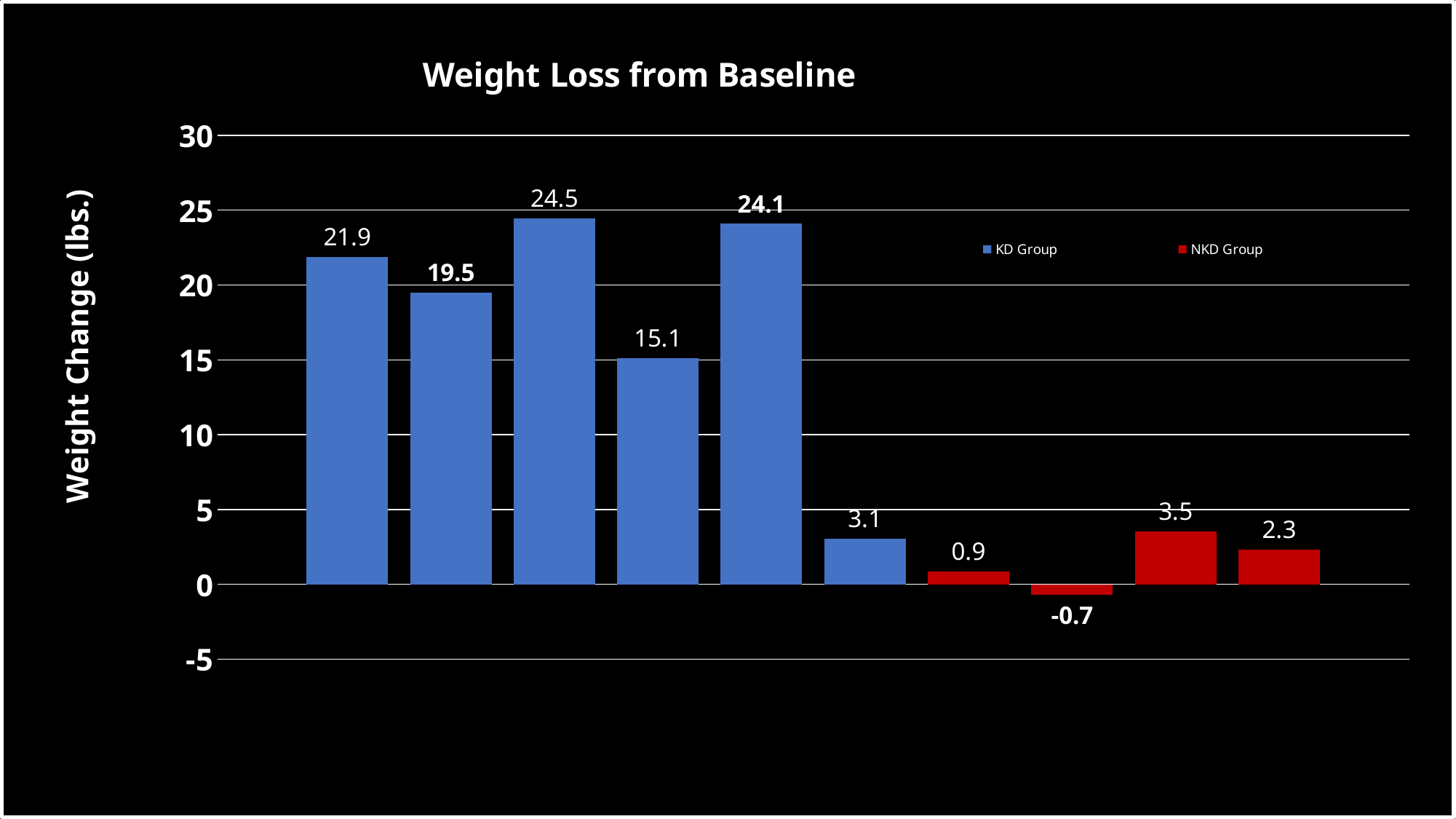
What is the difference between the highest KD Group value and the highest NKD Group value? 21.0 What are the two series named in the legend? KD Group and NKD Group What is the title of the chart? Weight Loss from Baseline How many bars belong to the NKD Group series? 4 How many bars belong to the KD Group series? 6 What is the highest value among the NKD Group bars? 3.5 What kind of chart is shown on the slide? bar chart What is the highest value shown on the chart? 24.5 What is the lowest value shown on the chart? -0.7 What is the lowest value among the KD Group bars? 3.1 How many series does the legend list? 2 How many bars are plotted in total on the chart? 10